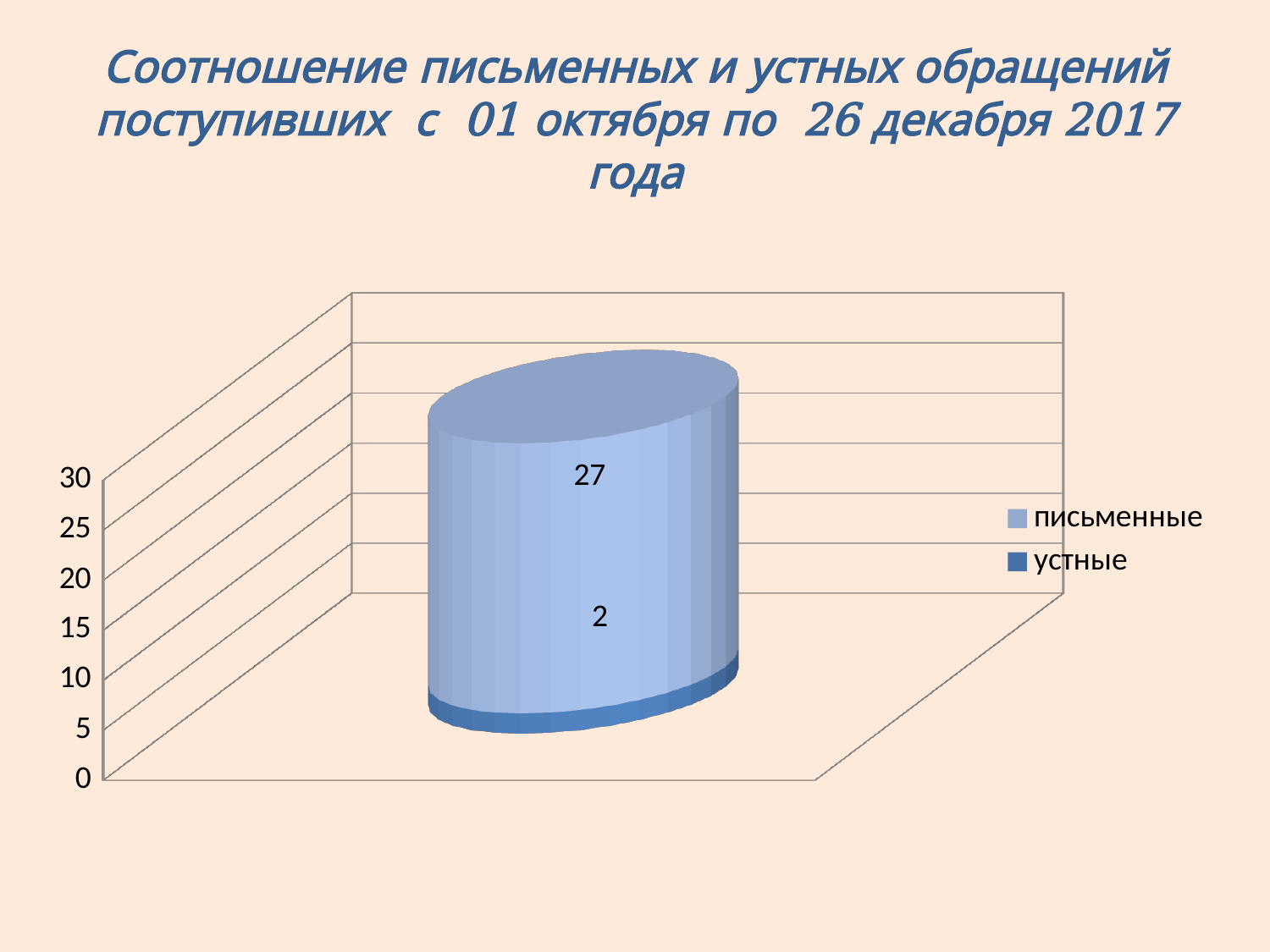
What is the value for the series "устные"? 2 What kind of chart is shown on the slide? bar chart Is the value for "письменные" greater or less than 20? greater What is the difference between the values for "письменные" and "устные"? 25 How many series does the legend list? 2 Which series has the highest value? письменные What is the total of the stacked bar? 29 What is the highest value shown on the vertical axis? 30 Which series has the higher value, "письменные" or "устные"? письменные Which series has the lowest value? устные What is the value for the series "письменные"? 27 Is the value for "устные" greater or less than 5? less